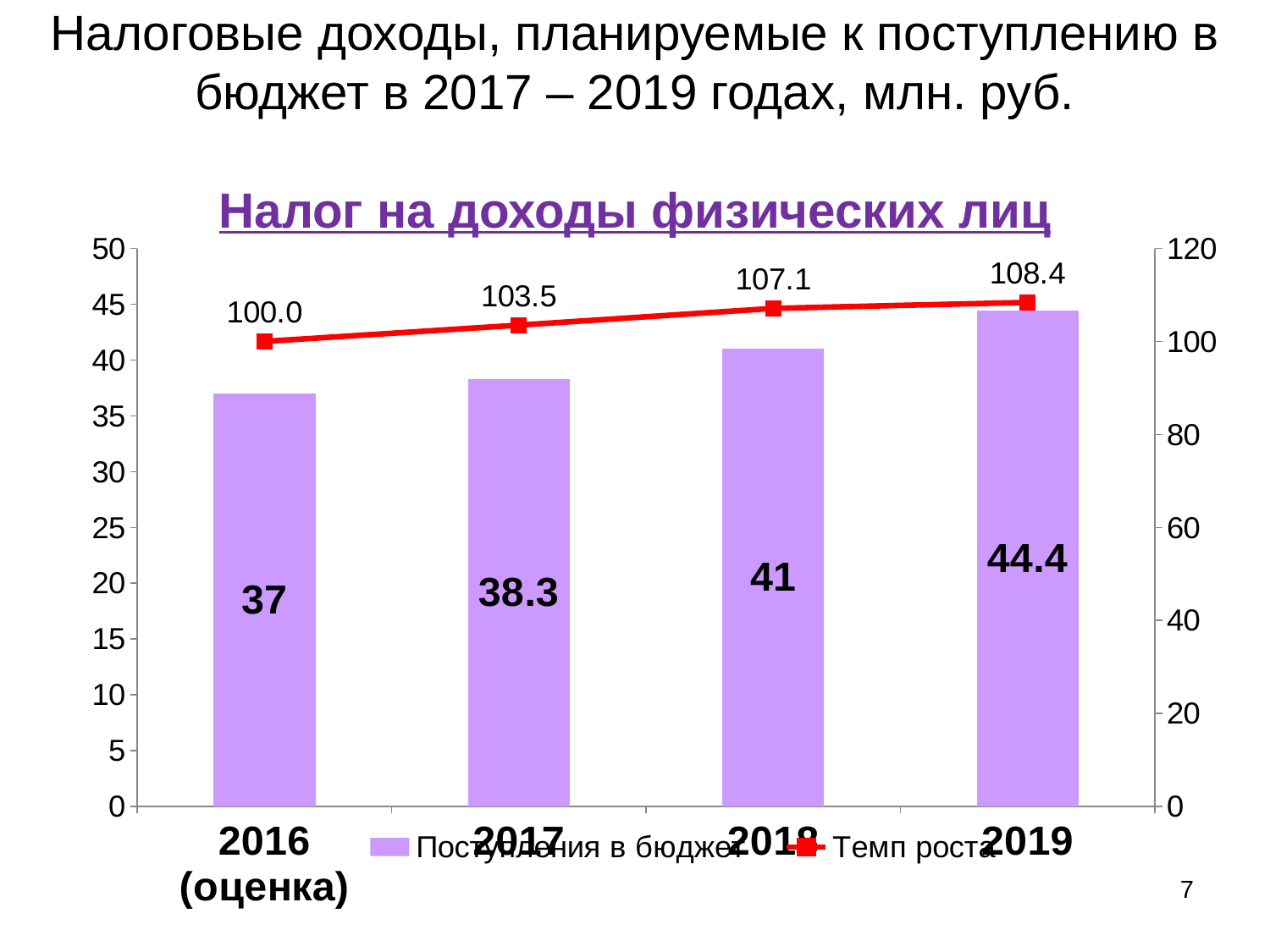
Do the values of 'Поступления в бюджет' rise or fall from 2016 to 2019? Rise What is the value of 'Поступления в бюджет' for 2016 (оценка)? 37 Which is larger: 'Поступления в бюджет' for 2017 or for 2018? 2018 What is the value of 'Темп роста' for 2018? 107.1 What is the value of 'Поступления в бюджет' for 2019? 44.4 What is the difference between 'Поступления в бюджет' for 2019 and 2018? 3.4 What is the title of the chart? Налог на доходы физических лиц Which year has the highest value of 'Поступления в бюджет'? 2019 How many series does the legend list? 2 Which year has the lowest value of 'Темп роста'? 2016 (оценка) What kind of chart is shown on the slide? Combined bar and line chart How many years are shown on the x axis? 4